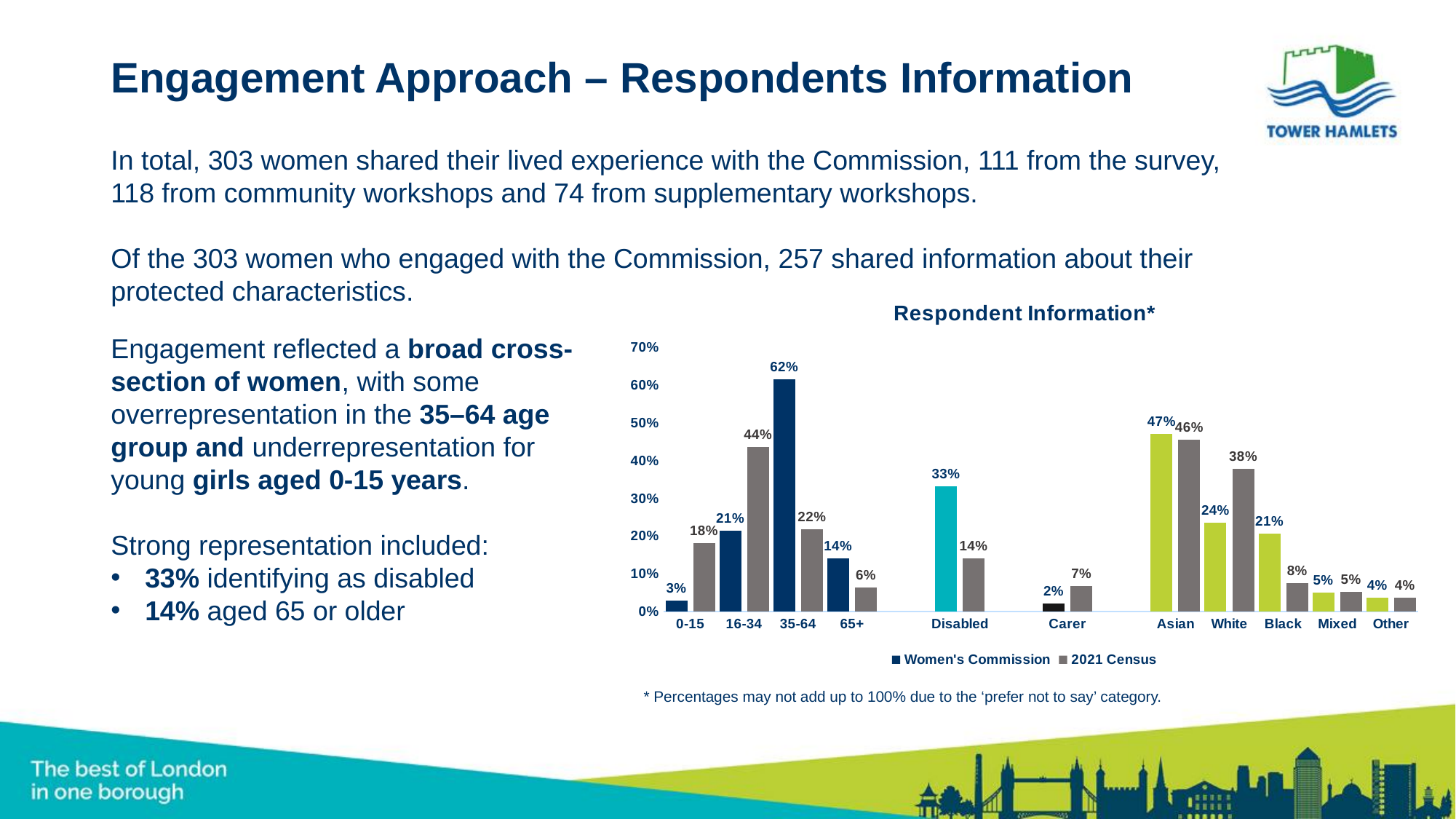
Which category has the highest Women's Commission value? 35-64 What is the 2021 Census value for the 16-34 age group? 44% How many series does the legend list? 2 What is the difference between the Women's Commission and 2021 Census values for Black? 13% What is the 2021 Census value for White? 38% Which category has the lowest Women's Commission value? Carer How many categories are shown on the x axis? 11 What type of chart is shown on the slide? Bar chart What is the title of the chart? Respondent Information* What is the Women's Commission value for the 35-64 age group? 62% What is the Women's Commission value for Disabled? 33% For the 0-15 age group, which is larger: the Women's Commission value or the 2021 Census value? 2021 Census